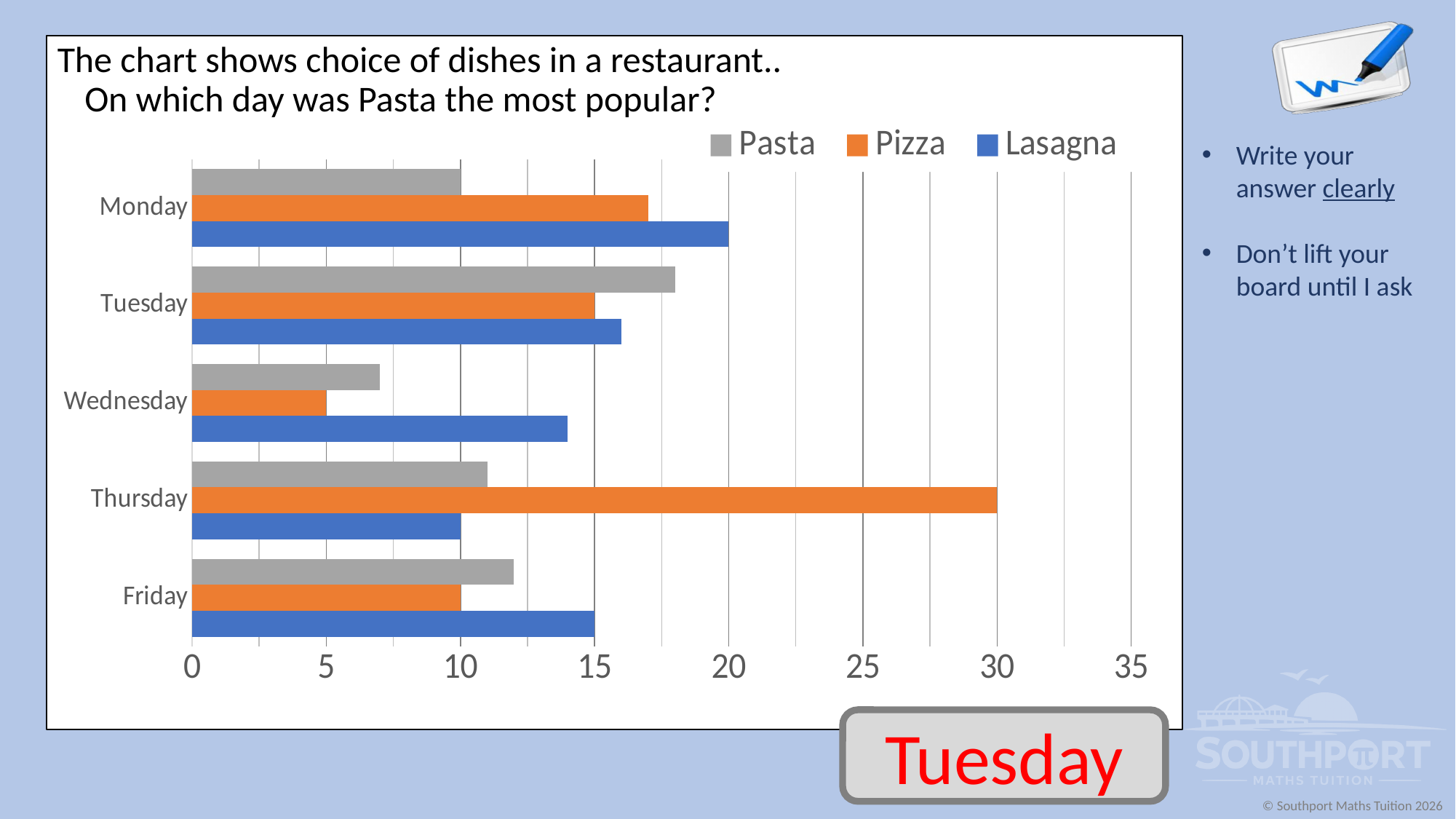
On Thursday, what is the difference between the Pizza value and the Lasagna value? 20 On which day was Pasta the most popular? Tuesday What colour represents Pizza in the legend? orange On Monday, which is larger: Pizza or Lasagna? Lasagna How many days are shown on the chart? 5 What is the value for Pizza on Thursday? 30 On which day was Pizza the least popular? Wednesday Is the value for Pasta on Wednesday greater or less than 10? less What is the value for Lasagna on Monday? 20 What kind of chart is shown on the slide? bar chart Is the value for Pasta on Tuesday greater or less than 15? greater How many series does the legend list? 3